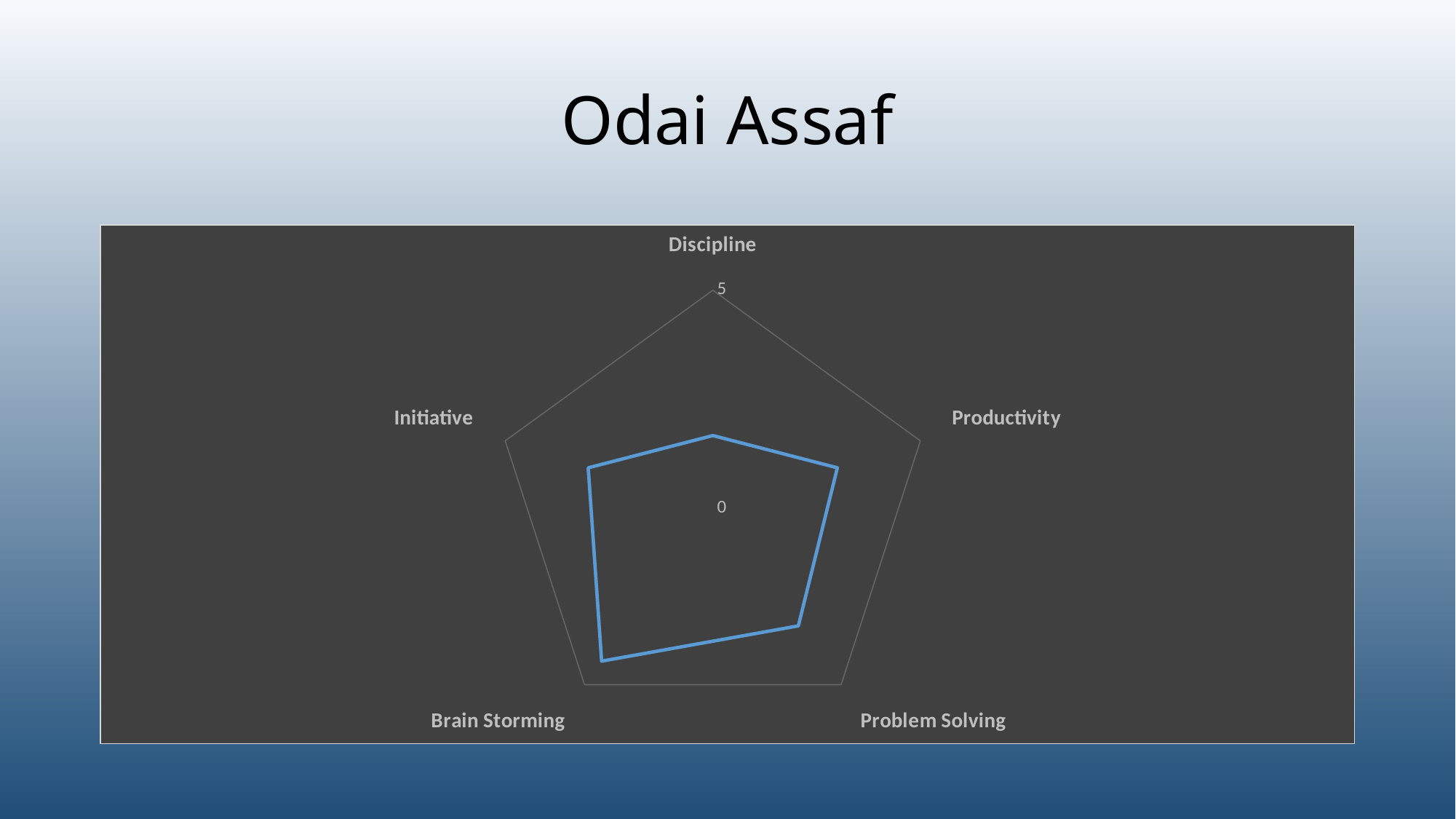
Which is larger, the value for Productivity or the value for Discipline? Productivity Which category has the lowest value on the radar chart? Discipline What kind of chart is shown on the slide? radar chart Is the value for Discipline greater or less than 5? less Which is larger, the value for Brain Storming or the value for Discipline? Brain Storming What is the maximum value shown on the radar chart's axis? 5 Is the value for Brain Storming greater or less than 5? less How many categories (axes) does the radar chart have? 5 What colour is the data line on the radar chart? blue Which category has the highest value on the radar chart? Brain Storming